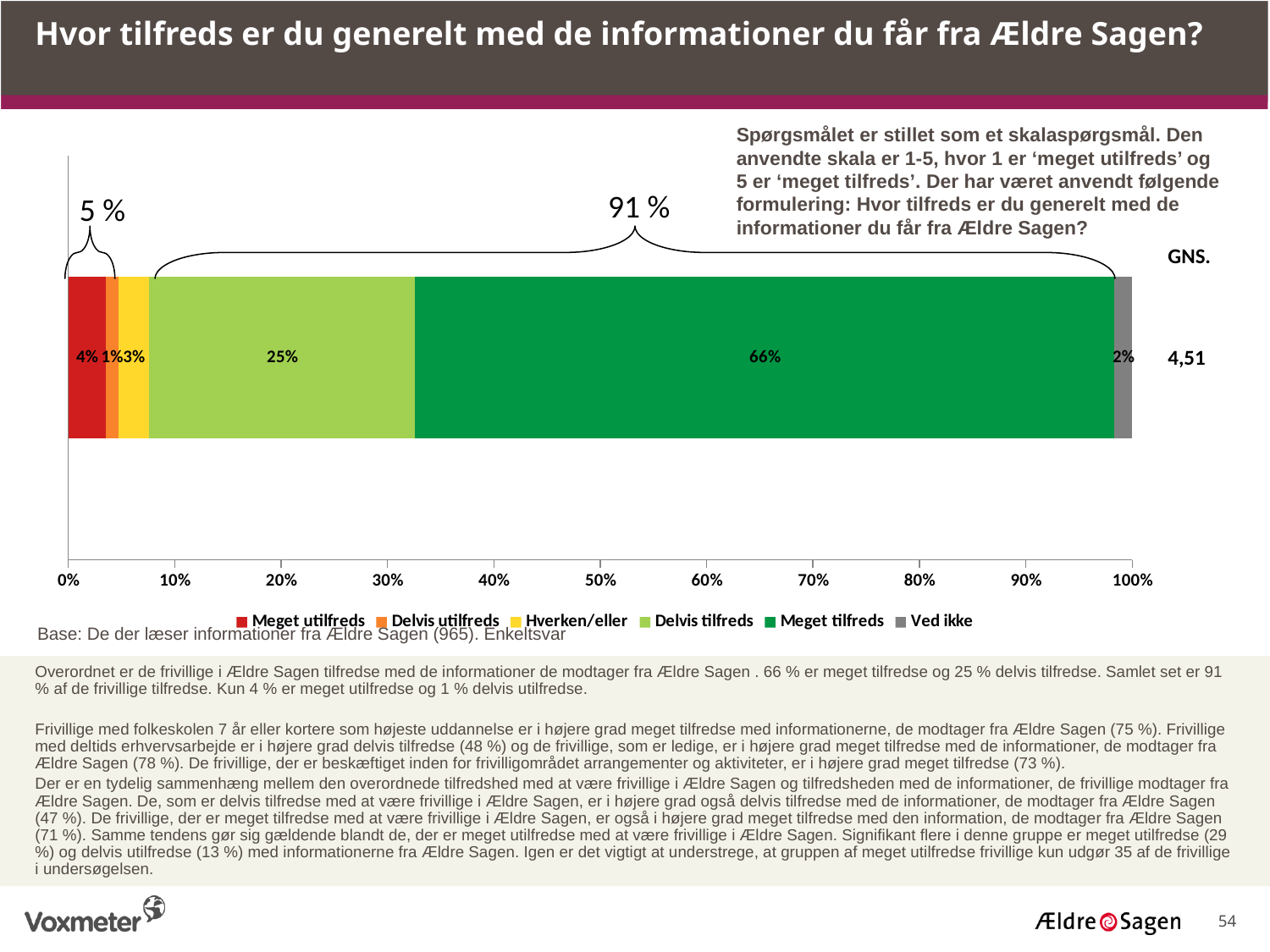
What percentage of respondents answered 'Delvis tilfreds'? 25% Which response category has the smallest share of the bar? Delvis utilfreds What is the average score (GNS.) shown to the right of the bar? 4,51 Which is larger, the share for 'Hverken/eller' or the share for 'Meget utilfreds'? Meget utilfreds What percentage of respondents answered 'Meget tilfreds'? 66% What percentage of respondents answered 'Meget utilfreds'? 4% What combined percentage is shown by the bracket above the 'Delvis tilfreds' and 'Meget tilfreds' segments? 91 % What kind of chart is shown on the slide? Stacked bar chart Which response category has the largest share of the bar? Meget tilfreds What percentage of respondents answered 'Ved ikke'? 2% What is the difference in percentage points between 'Meget tilfreds' and 'Delvis tilfreds'? 41 How many series does the legend list? 6